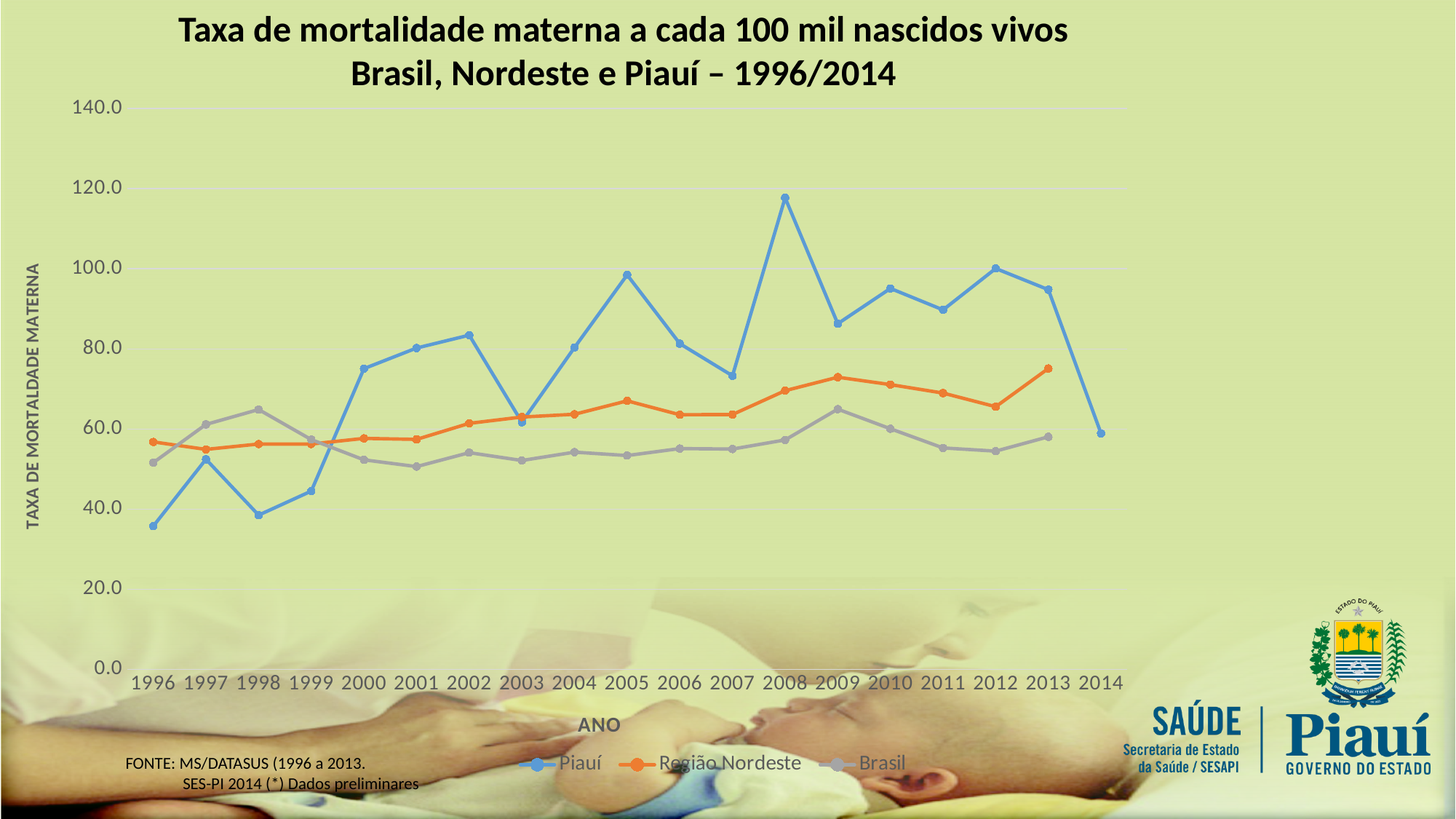
In which year does the Região Nordeste series reach its highest value? 2013 In which year does the Piauí series reach its highest value? 2008 What kind of chart is shown on the slide? line chart Does the Região Nordeste series generally rise or fall from 1996 to 2013? rise How many years are plotted along the x axis? 19 How many series does the legend list? 3 In which year does the Piauí series have its lowest value? 1996 Is the value for Brasil in 2001 greater or less than 60? less Is the value for Piauí in 2008 greater or less than 100? greater Is the value for Piauí in 1996 greater or less than 40? less Which series has the higher value in 2010, Piauí or Brasil? Piauí What is the label of the x axis? ANO